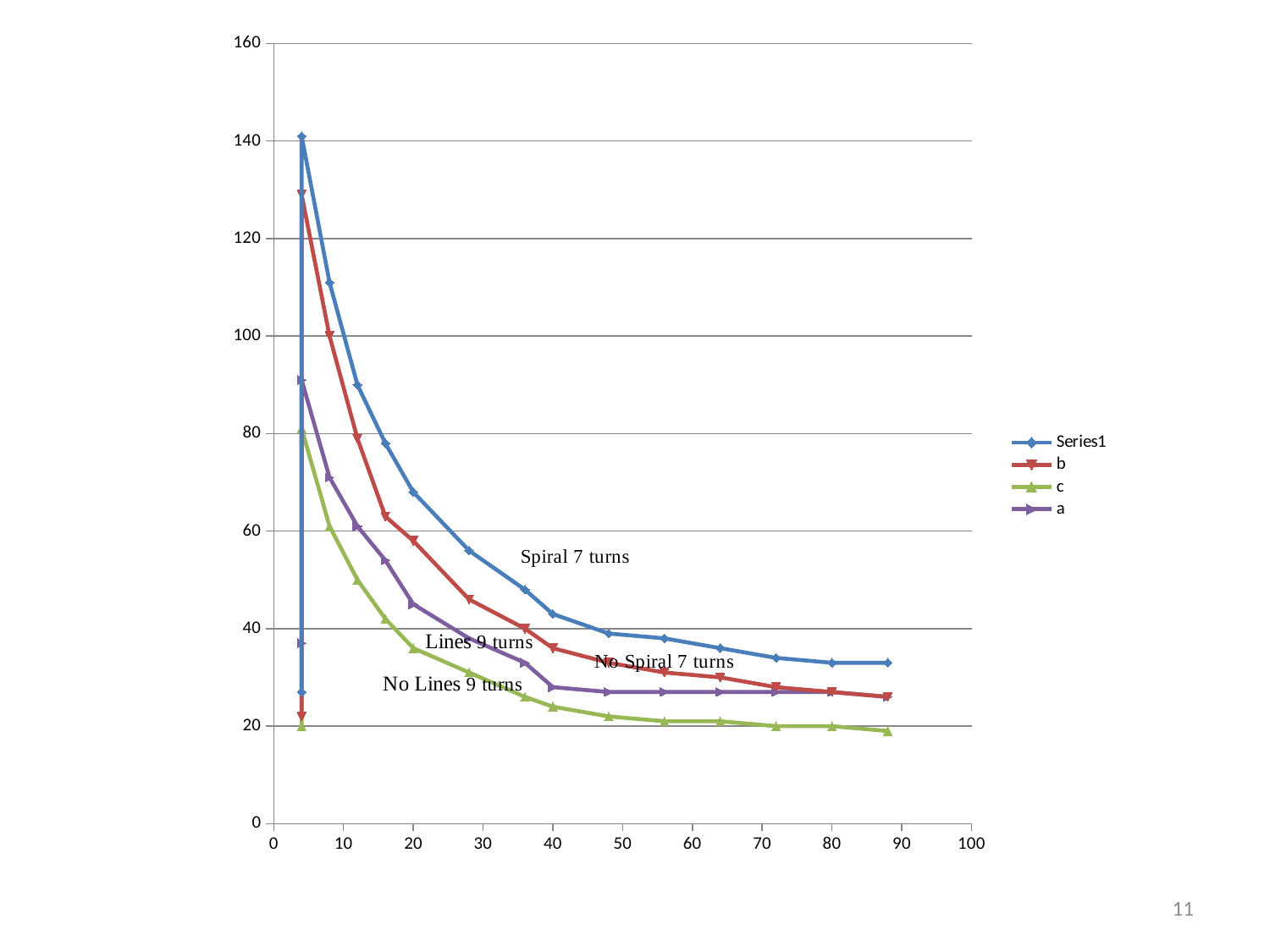
Is the value for Series1 at x = 12 greater or less than 80? greater Do the values of Series1 rise or fall as the x-axis value increases? fall Is the value for series a at x = 88 greater or less than 20? greater How many series does the legend list? 4 Is the value for series b at x = 20 greater or less than 40? greater Which text annotation is placed next to the blue Series1 line? Spiral 7 turns What are the names of the series listed in the legend? Series1, b, c, a At x = 40, which is larger: the value for Series1 or the value for series c? Series1 Which series has the highest values across the chart? Series1 What kind of chart is shown on the slide? line chart Which series has the lowest values across the chart? c